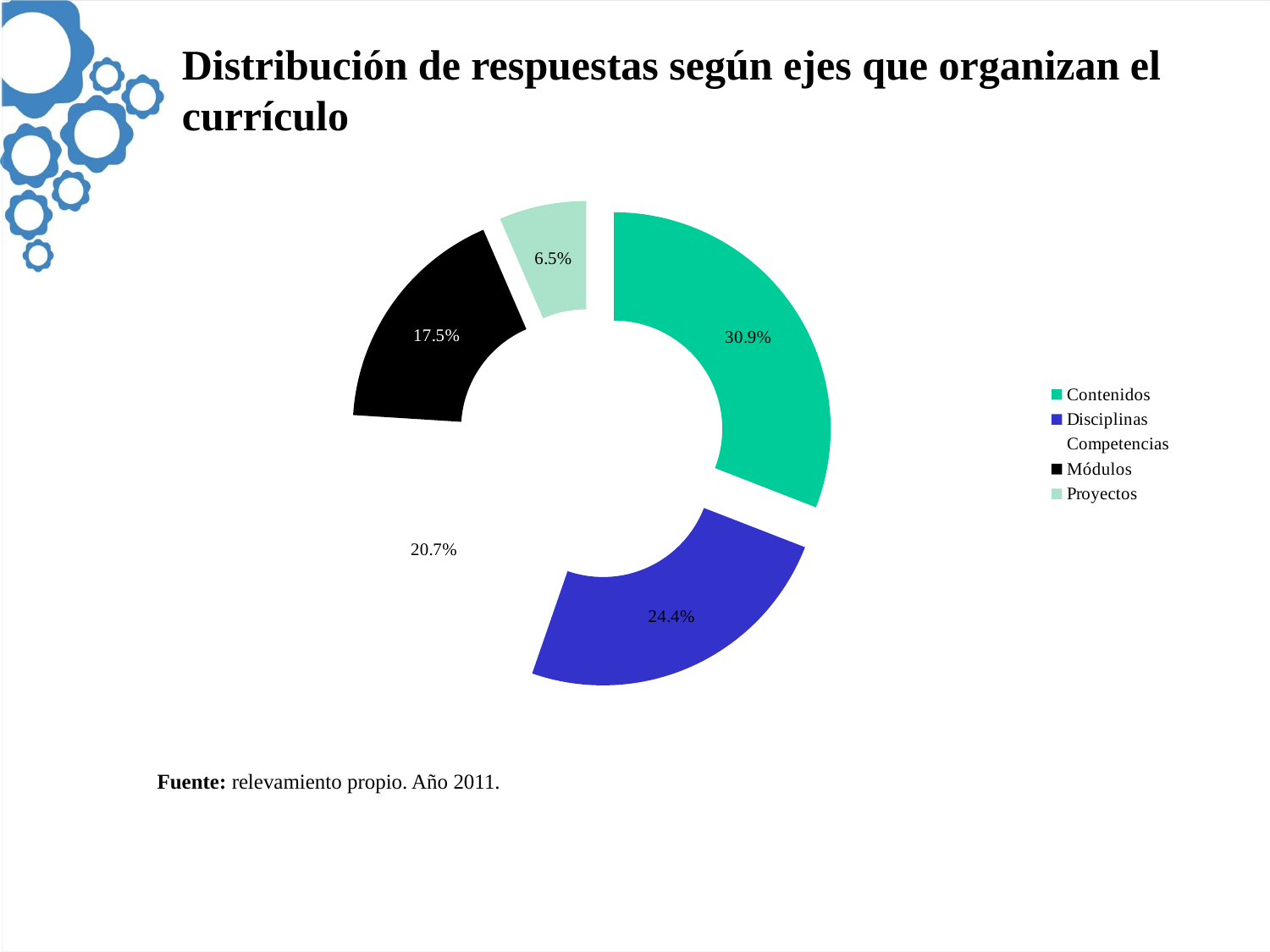
Which category has the smallest share of responses? Proyectos Which has a larger share, Módulos or Proyectos? Módulos What percentage of responses corresponds to Disciplinas? 24.4% What percentage of responses corresponds to Proyectos? 6.5% What is the title of the chart on the slide? Distribución de respuestas según ejes que organizan el currículo What is the difference in percentage points between Contenidos and Disciplinas? 6.5 What percentage of responses corresponds to Módulos? 17.5% How many categories does the legend list? 5 Which category has the largest share of responses? Contenidos What kind of chart is shown on the slide? Doughnut (pie) chart What percentage of responses corresponds to Competencias? 20.7% What percentage of responses corresponds to Contenidos? 30.9%